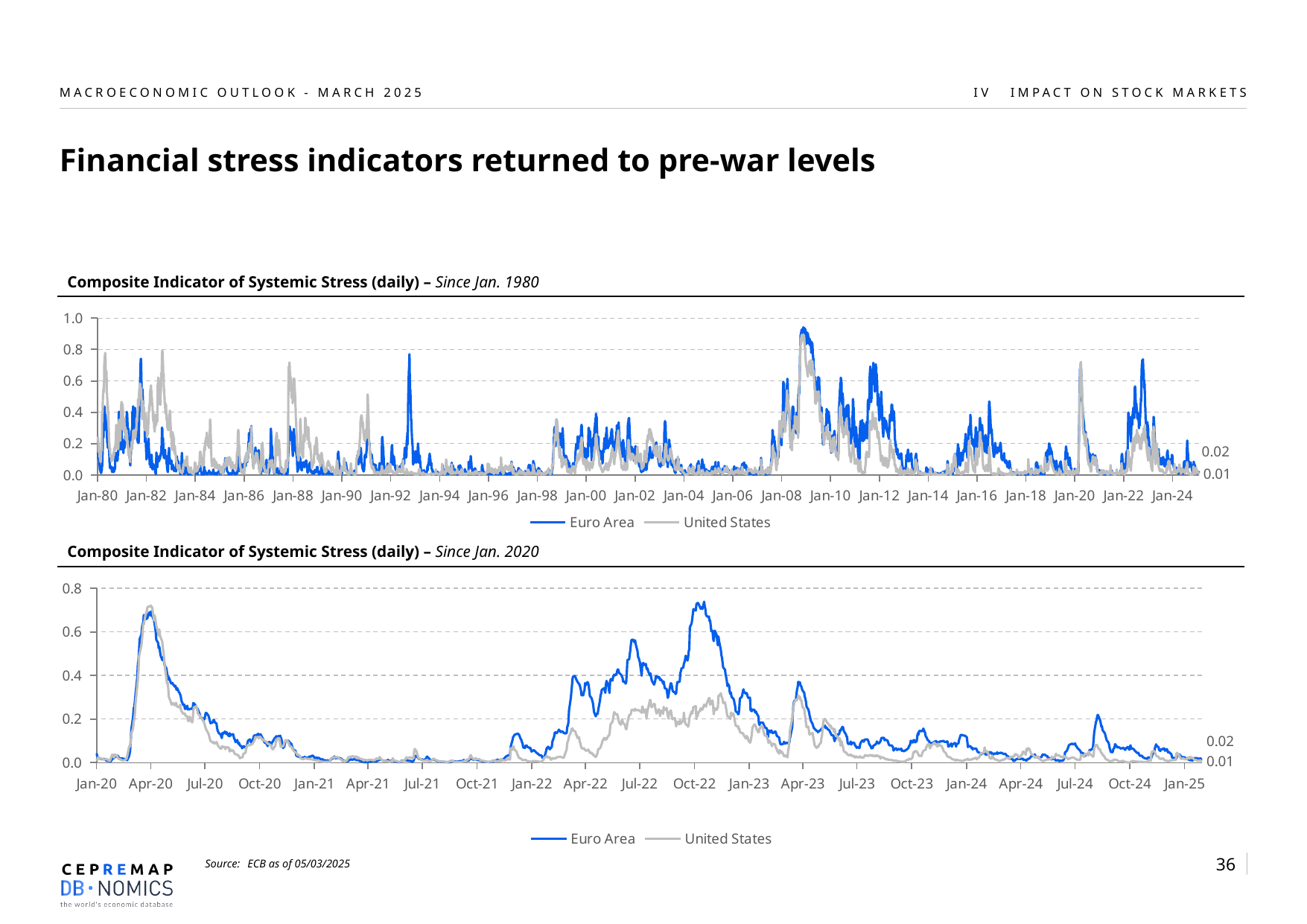
In the top chart (Since Jan. 1980), is the Euro Area peak around Jan-08 to Jan-10 greater or less than 0.8? greater How many series does the legend of the bottom chart (Since Jan. 2020) list? 2 In the top chart (Since Jan. 1980), what is the latest value shown for the United States? 0.01 In the bottom chart (Since Jan. 2020), does the Euro Area series rise or fall between Oct-22 and Jan-23? Fall What kind of chart is the top chart (Since Jan. 1980)? Line chart In the bottom chart (Since Jan. 2020), what is the latest value shown for the Euro Area? 0.02 In the bottom chart (Since Jan. 2020), what is the latest value shown for the United States? 0.01 In the bottom chart (Since Jan. 2020), which series has the higher latest value, Euro Area or United States? Euro Area In the bottom chart (Since Jan. 2020), what is the difference between the latest Euro Area value and the latest United States value? 0.01 In the top chart (Since Jan. 1980), what is the latest value shown for the Euro Area? 0.02 In the bottom chart (Since Jan. 2020), is the Euro Area peak around Oct-22 greater or less than 0.6? greater In the bottom chart (Since Jan. 2020), is the United States value around Oct-22 greater or less than 0.4? less